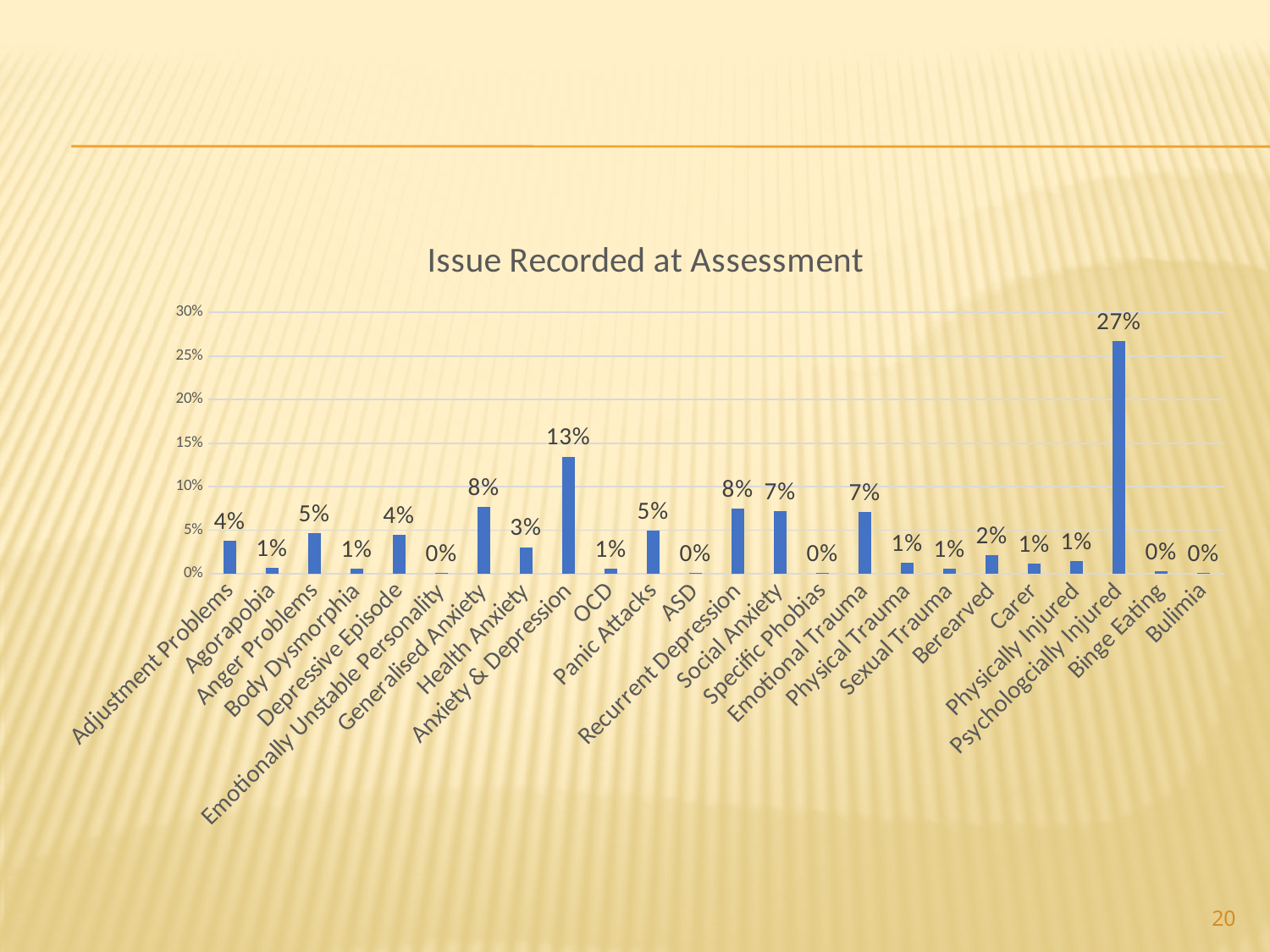
Which is larger, the value for Social Anxiety or the value for Panic Attacks? Social Anxiety What is the value for Berearved? 2% Is the value for Anxiety & Depression greater or less than 10%? greater How many categories are shown on the x axis? 24 Which category has the highest value? Psychologcially Injured What is the value for Anxiety & Depression? 13% What is the value for Psychologcially Injured? 27% What is the value for Generalised Anxiety? 8% What is the title of the chart? Issue Recorded at Assessment What is the difference between the values for Recurrent Depression and Health Anxiety? 5% What kind of chart is this? bar chart What is the difference between the values for Psychologcially Injured and Anxiety & Depression? 14%